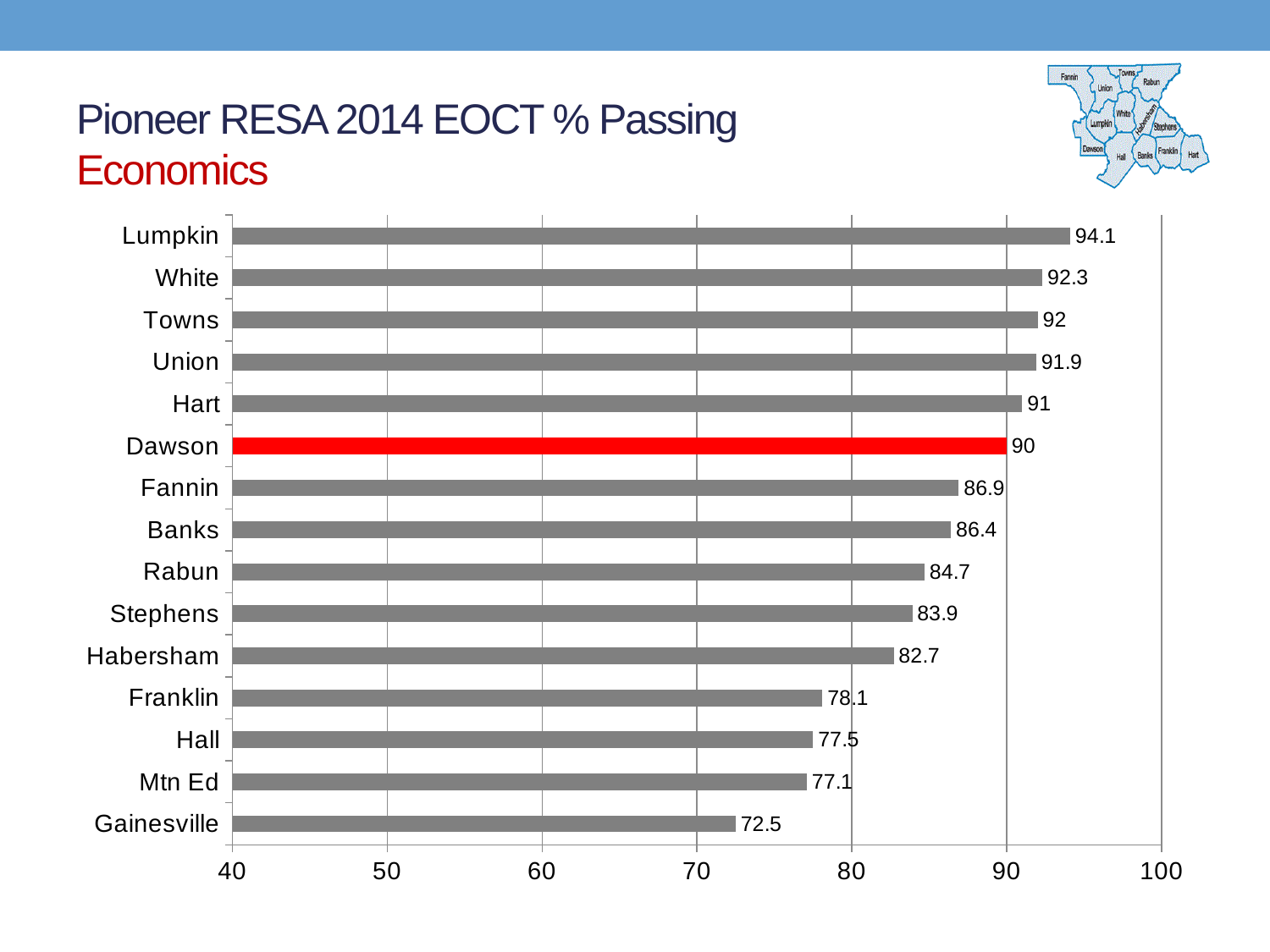
What kind of chart is shown on the slide? bar chart Which category has the highest value? Lumpkin What is the value for Fannin? 86.9 What is the difference between the values for Dawson and Hall? 12.5 Is the value for Habersham greater or less than 80? greater How many categories are shown in the chart? 15 What is the value for Gainesville? 72.5 What is the value for Dawson? 90 Which is larger, the value for Banks or the value for Rabun? Banks What is the difference between the values for Lumpkin and Gainesville? 21.6 Which category's bar is highlighted in red? Dawson Which category has the lowest value? Gainesville